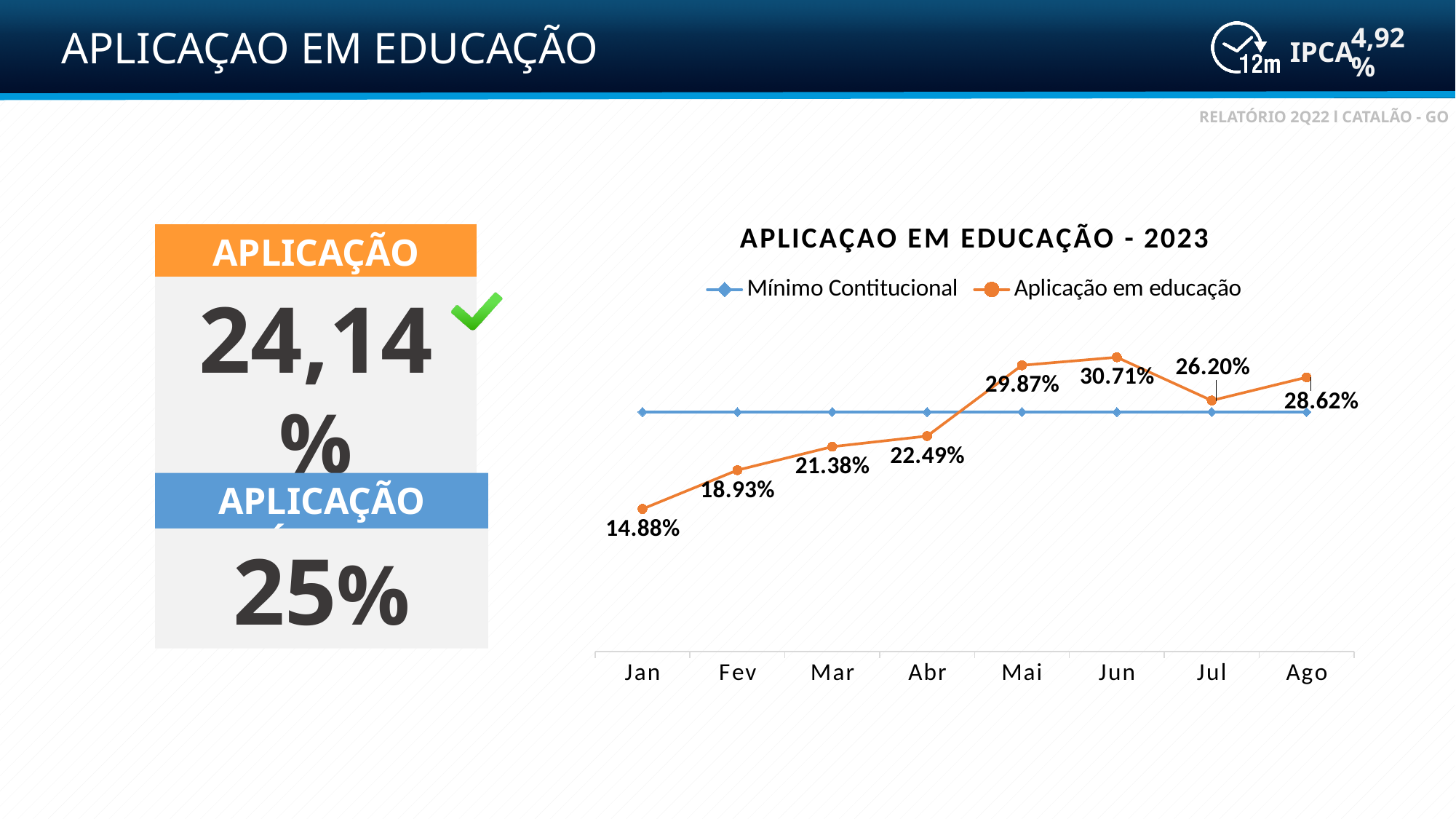
In which month is Aplicação em educação lowest? Jan What is the value of Aplicação em educação in Mai? 29.87% How many series does the chart legend list? 2 What is the difference between the Aplicação em educação values for Jul and Ago? 2.42% What kind of chart is shown on the slide? Line chart What is the value of Aplicação em educação in Ago? 28.62% In which month is Aplicação em educação highest? Jun What is the value of Aplicação em educação in Jan? 14.88% Does the Aplicação em educação line rise or fall from Jan to Jun? Rise What is the difference between the Aplicação em educação values for Jun and Jan? 15.83% Which month has a higher Aplicação em educação value, Mar or Abr? Abr How many months are shown on the x axis of the chart? 8